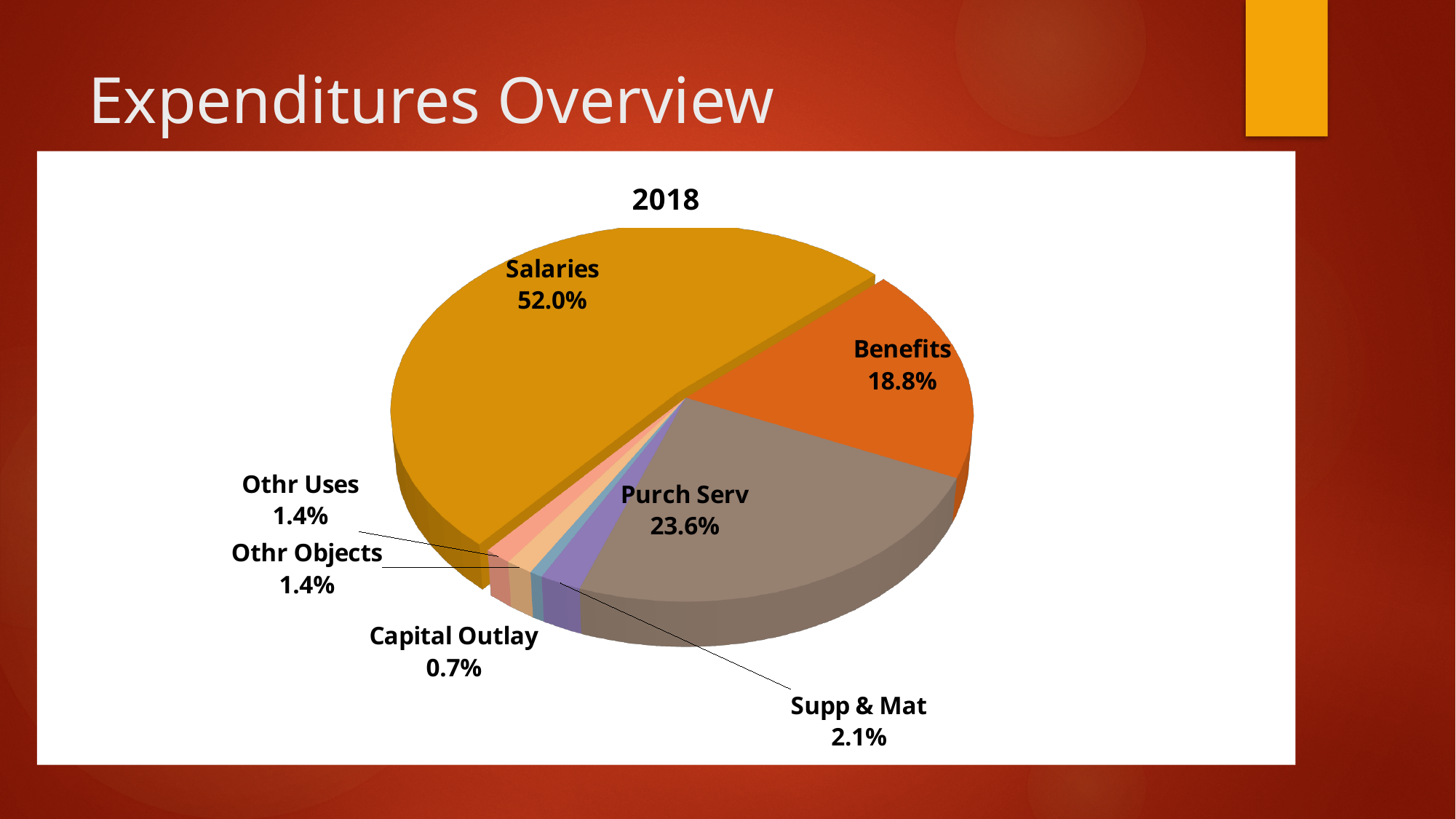
What is the difference between the Salaries share and the Benefits share? 33.2% What is the value shown for Benefits? 18.8% Which category has the smallest slice of the pie? Capital Outlay How many categories are shown in the pie chart? 7 What is the value shown for Capital Outlay? 0.7% Which category has the largest slice of the pie? Salaries What kind of chart is shown on the slide? Pie chart What share of the pie does Salaries represent? 52.0% What is the value shown for Purch Serv? 23.6% What is the value shown for Supp & Mat? 2.1% What is the title of the chart? 2018 Which is larger, Purch Serv or Benefits? Purch Serv